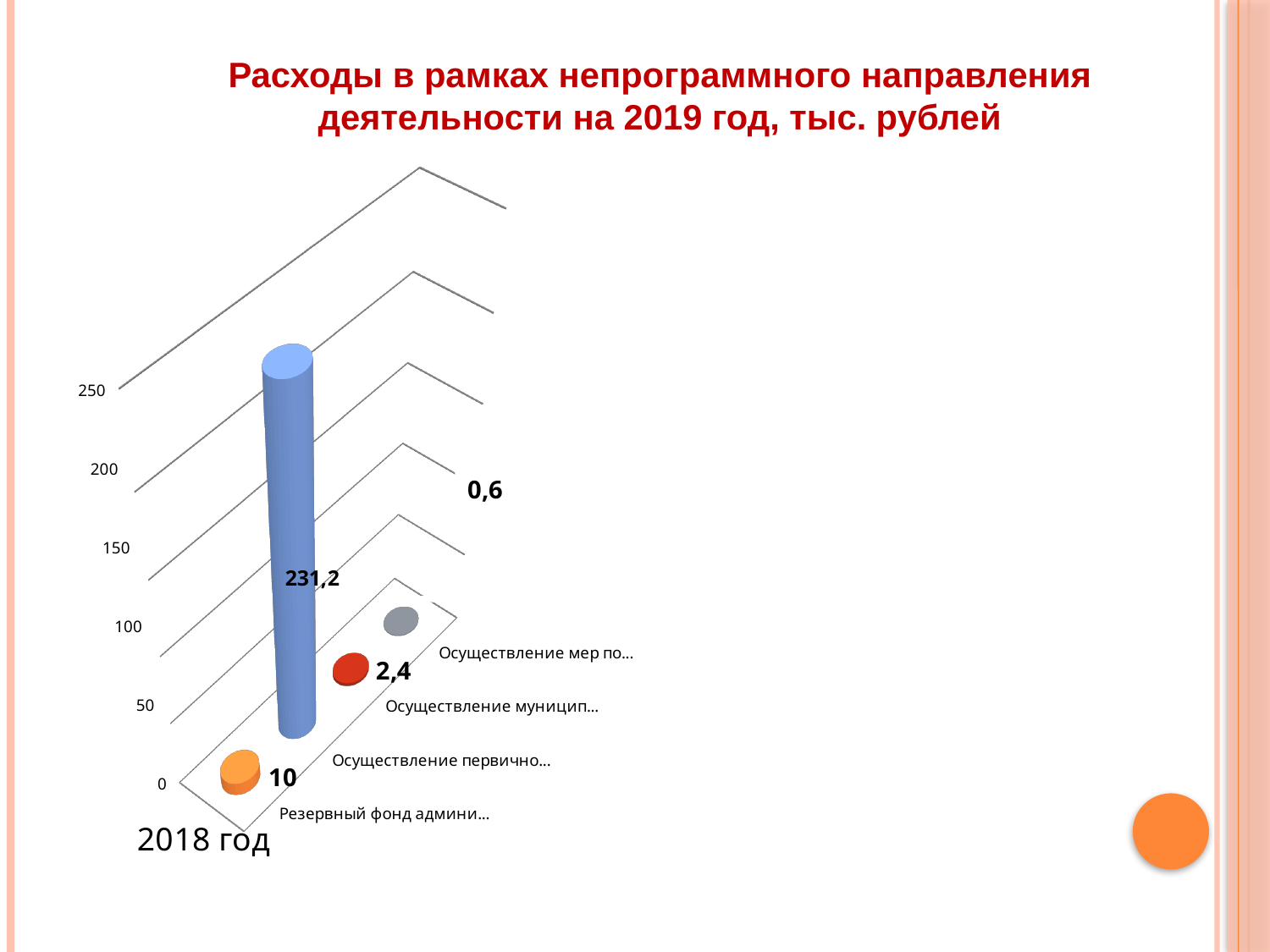
What kind of chart is shown on the slide? bar chart What is the difference between the values for "Осуществление муницип…" and "Осуществление мер по…"? 1,8 What is the value for "Осуществление первично…"? 231,2 Which is larger: the value for "Резервный фонд админи…" or for "Осуществление муницип…"? Резервный фонд админи… What is the value for "Осуществление мер по…"? 0,6 Which item has the lowest value? Осуществление мер по… How many bars are plotted on the chart? 4 What is the difference between the values for "Осуществление первично…" and "Резервный фонд админи…"? 221,2 Which item has the highest value? Осуществление первично… What is the value for "Осуществление муницип…"? 2,4 Is the value for "Осуществление первично…" greater or less than 200? greater What is the value for "Резервный фонд админи…"? 10